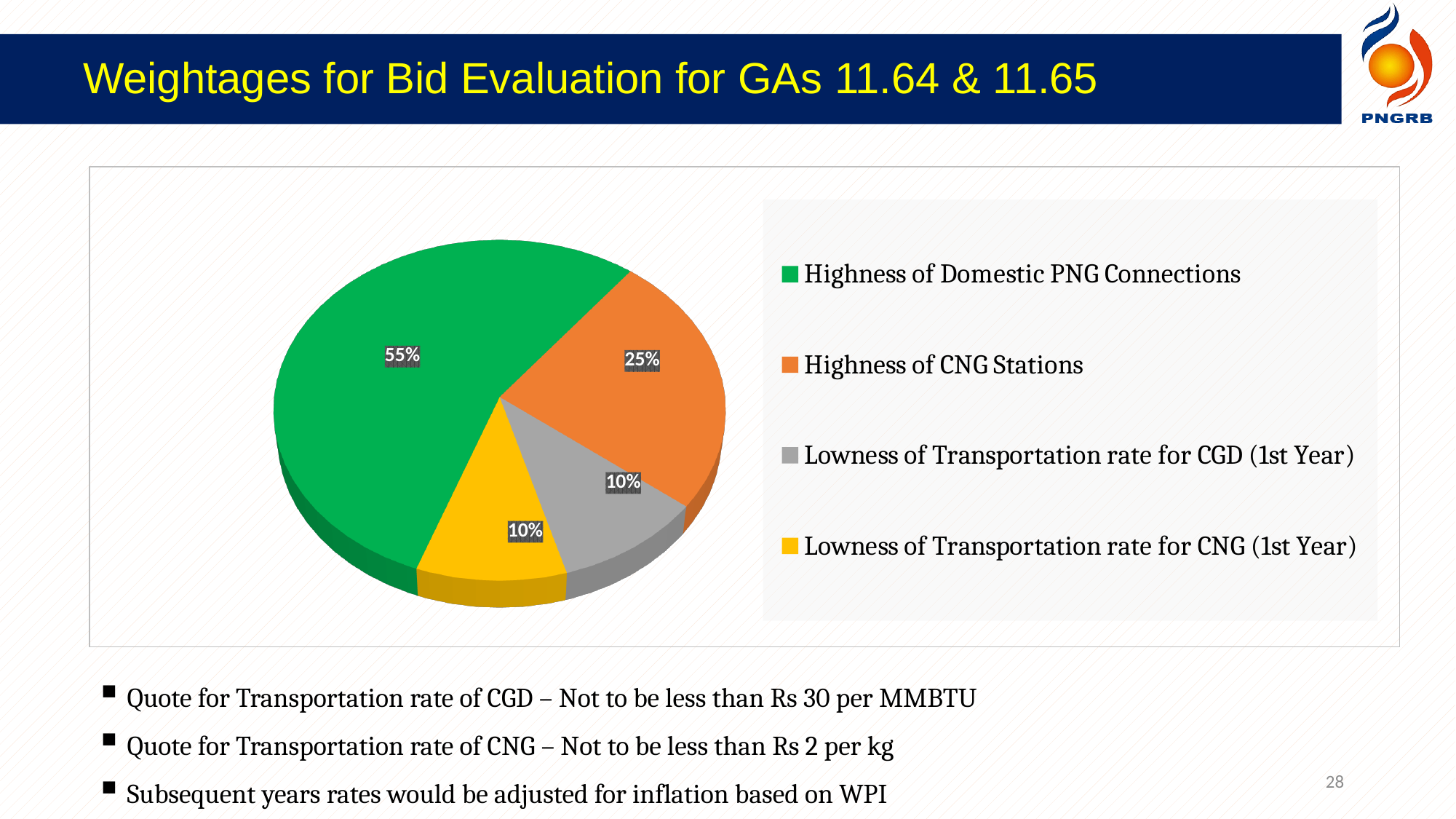
What is the difference between the weightage for Highness of Domestic PNG Connections and Highness of CNG Stations? 30% What is the weightage for Highness of Domestic PNG Connections? 55% Which is larger: the weightage for Highness of CNG Stations or for Lowness of Transportation rate for CGD (1st Year)? Highness of CNG Stations What colour represents Highness of CNG Stations in the pie chart? Orange How many categories does the legend list? 4 What is the weightage for Lowness of Transportation rate for CNG (1st Year)? 10% What kind of chart is shown on the slide? Pie chart Which category has the largest share of the pie? Highness of Domestic PNG Connections What colour represents Lowness of Transportation rate for CNG (1st Year)? Yellow What is the weightage for Highness of CNG Stations? 25% What is the weightage for Lowness of Transportation rate for CGD (1st Year)? 10% What is the combined share of the two Lowness of Transportation rate categories? 20%